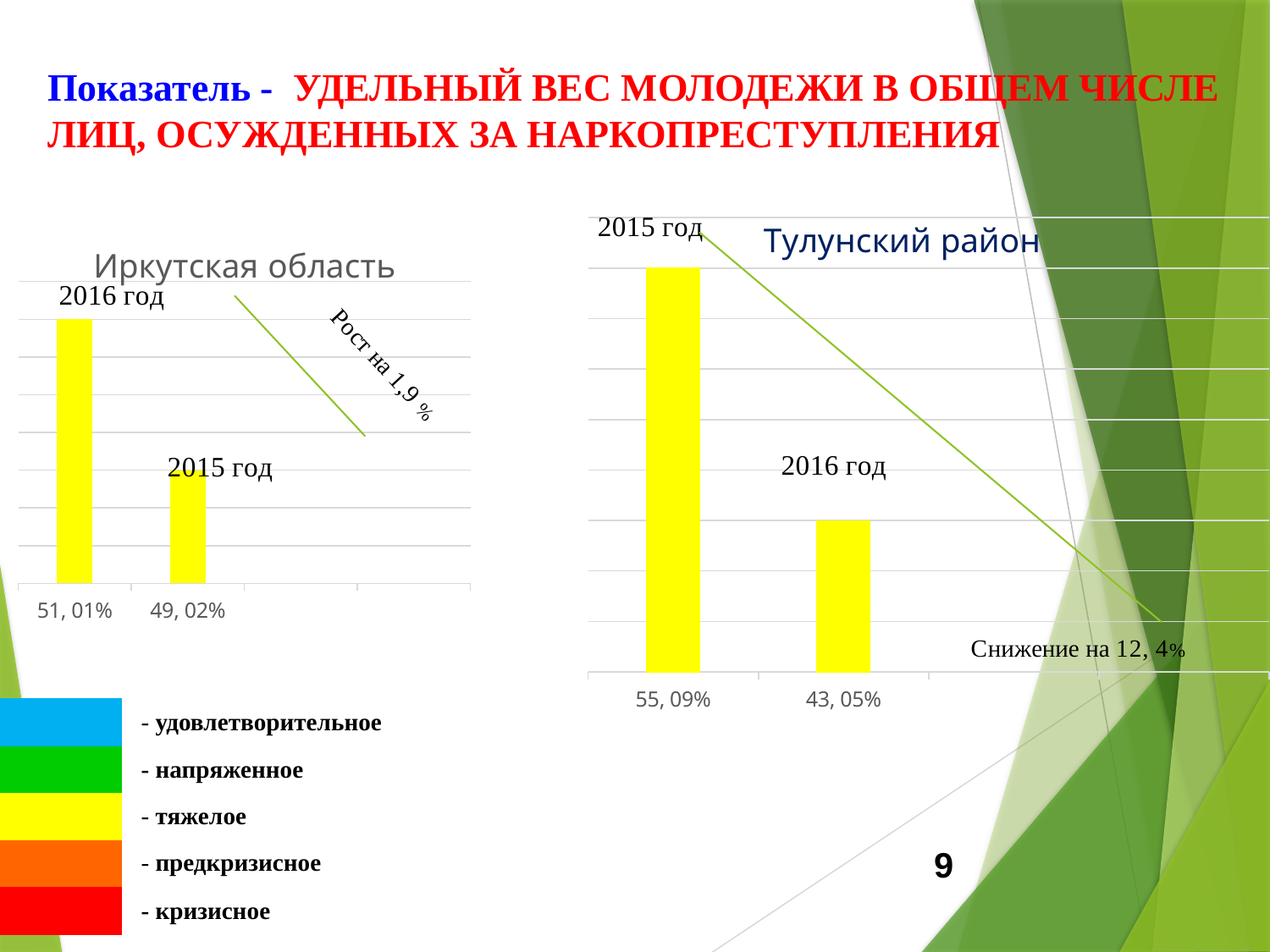
On the Тулунский район chart, what is the value for 2015 год? 55, 09% What type of chart is the Иркутская область chart? bar chart How many bars are shown on the Тулунский район chart? 2 On the Иркутская область chart, is the value for 2016 год larger or smaller than the value for 2015 год? larger On the Тулунский район chart, what is the value for 2016 год? 43, 05% On the Тулунский район chart, which year has the higher value? 2015 год On the Иркутская область chart, what is the value for 2016 год? 51, 01% What change does the annotation on the Тулунский район chart state? Снижение на 12, 4% On the Иркутская область chart, which year has the lower value? 2015 год On the Иркутская область chart, what is the value for 2015 год? 49, 02% What change does the annotation on the Иркутская область chart state? Рост на 1,9 % On the Тулунский район chart, what is the difference between the 2015 год and 2016 год values? 12,04%